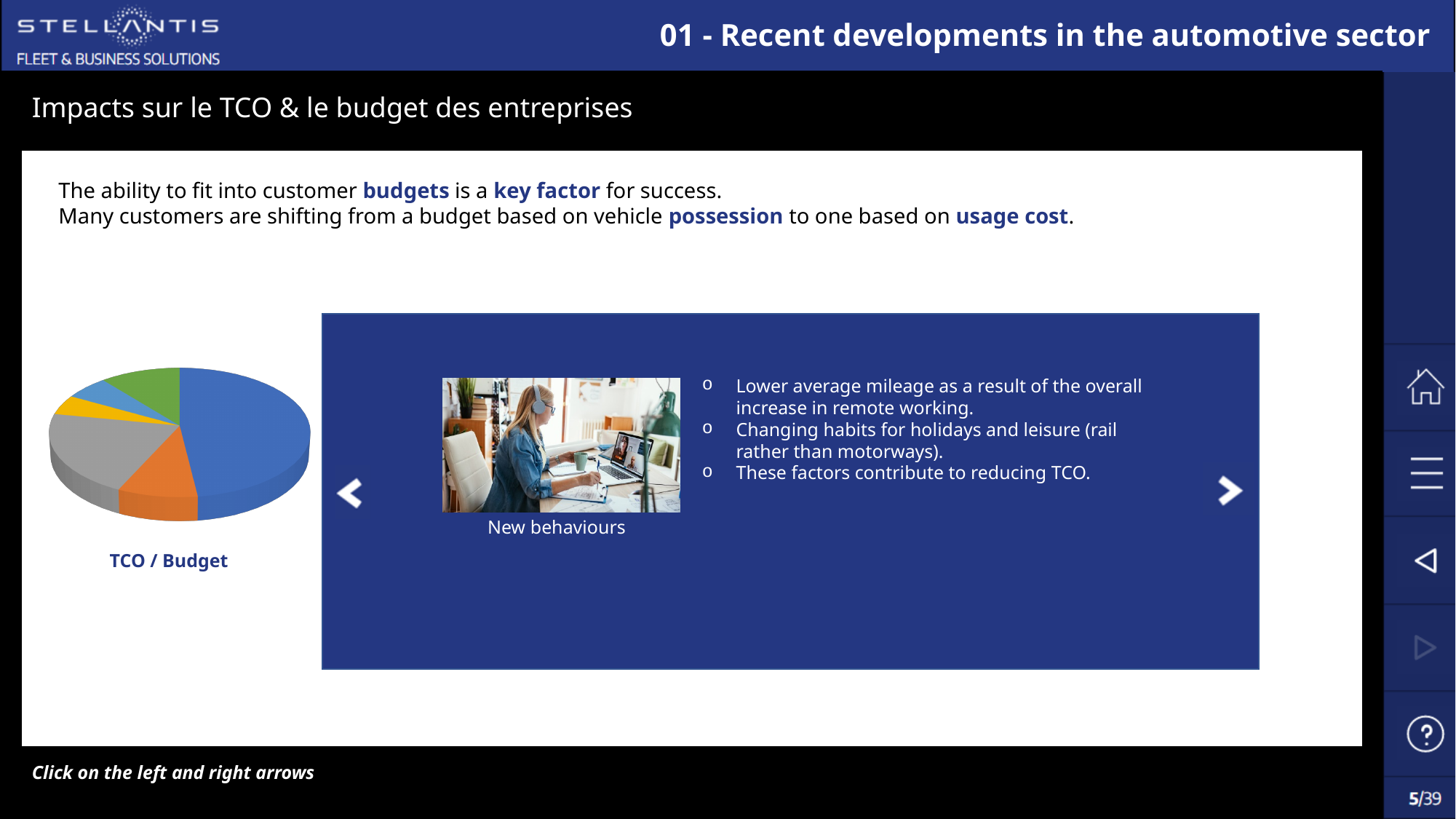
In the pie chart, which is larger, the blue slice or the orange slice? Blue In the pie chart, which is larger, the green slice or the yellow slice? Green Does the pie chart display a legend? No What is the title shown under the pie chart? TCO / Budget How many slices does the pie chart have? 6 Which colour slice is the largest in the pie chart? Blue What kind of chart is shown on the left of the slide? Pie chart In the pie chart, which is larger, the gray slice or the light blue slice? Gray